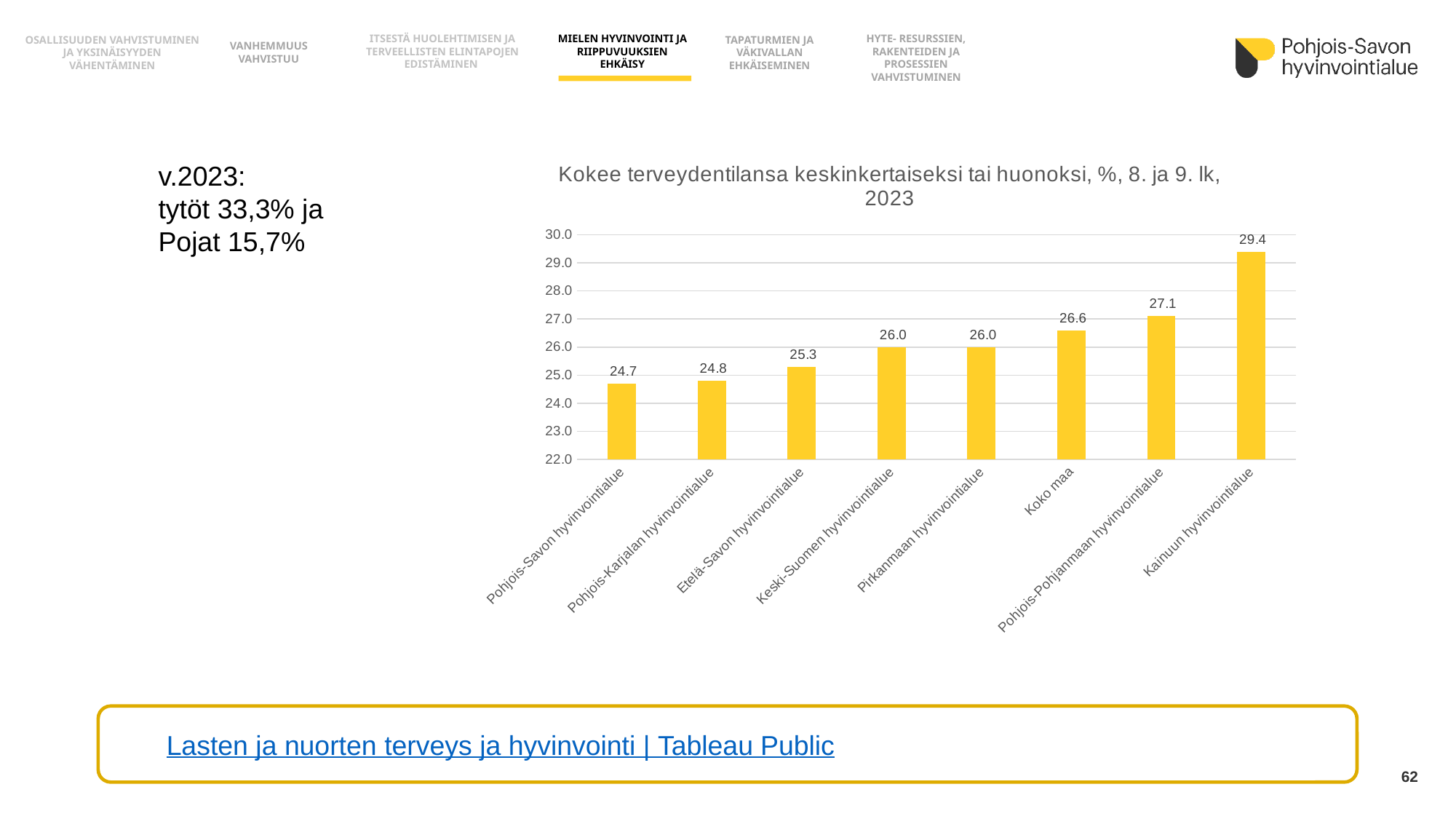
Do the values rise or fall from left to right along the x axis? Rise What is the difference between the values for Kainuun hyvinvointialue and Pohjois-Savon hyvinvointialue? 4.7 How many categories are shown on the x axis? 8 What is the title of the chart? Kokee terveydentilansa keskinkertaiseksi tai huonoksi, %, 8. ja 9. lk, 2023 Which is larger, the value for Pohjois-Pohjanmaan hyvinvointialue or the value for Koko maa? Pohjois-Pohjanmaan hyvinvointialue What kind of chart is shown on the slide? Bar chart What is the value for Kainuun hyvinvointialue? 29.4 What is the value for Koko maa? 26.6 Which category has the lowest value? Pohjois-Savon hyvinvointialue Which category has the highest value? Kainuun hyvinvointialue What is the value for Etelä-Savon hyvinvointialue? 25.3 What is the value for Pohjois-Savon hyvinvointialue? 24.7